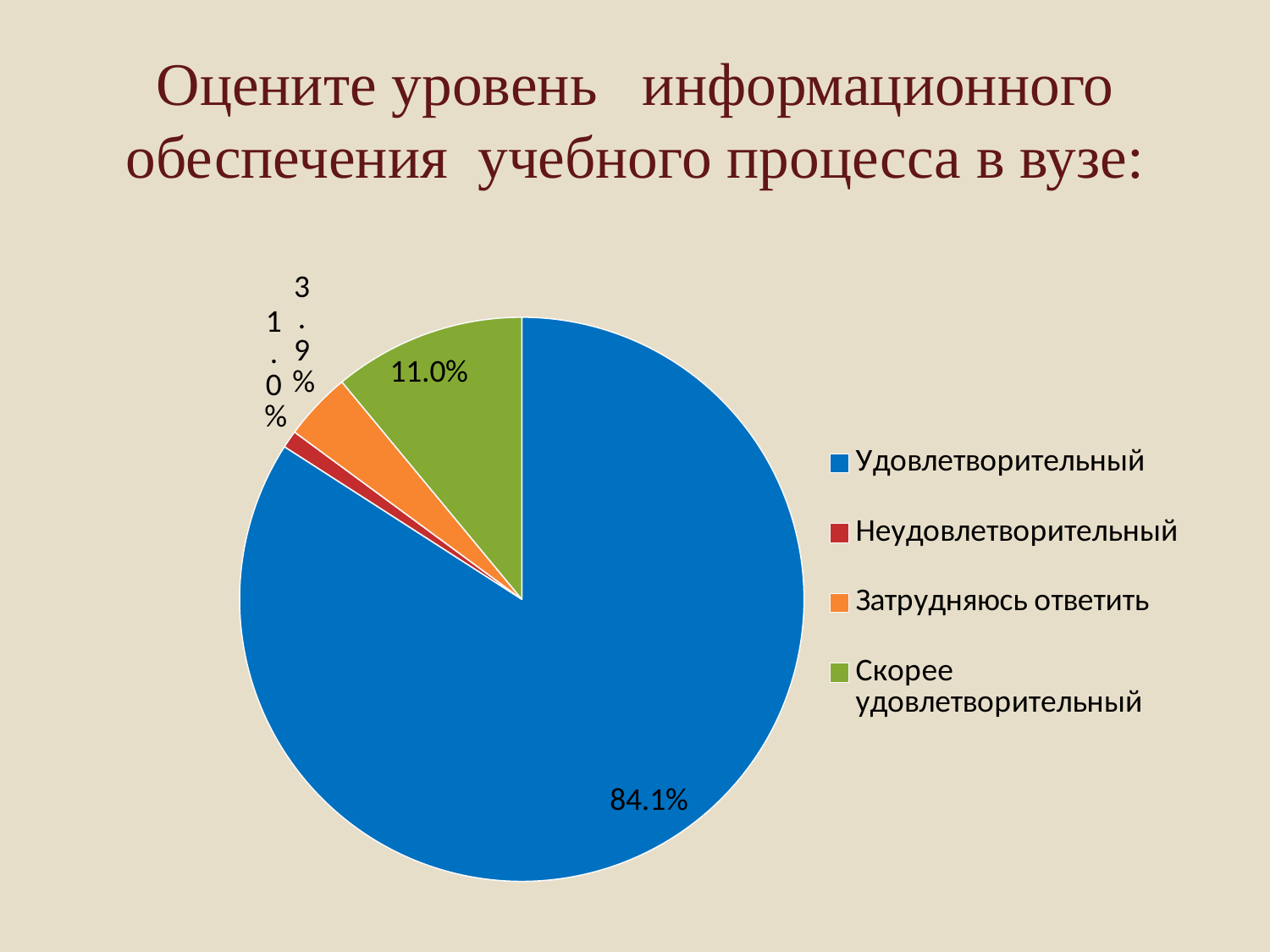
Which category has the largest slice of the pie? Удовлетворительный What colour is the slice for Затрудняюсь ответить? orange How many slices does the pie chart have? 4 Which category has the smallest slice of the pie? Неудовлетворительный What share of the pie does Затрудняюсь ответить take? 3.9% What share of the pie does Неудовлетворительный take? 1.0% What kind of chart is shown on the slide? pie chart Which is larger, the share of Затрудняюсь ответить or the share of Скорее удовлетворительный? Скорее удовлетворительный What is the difference between the shares of Удовлетворительный and Скорее удовлетворительный? 73.1% How many entries does the legend list? 4 What share of the pie does Удовлетворительный take? 84.1%